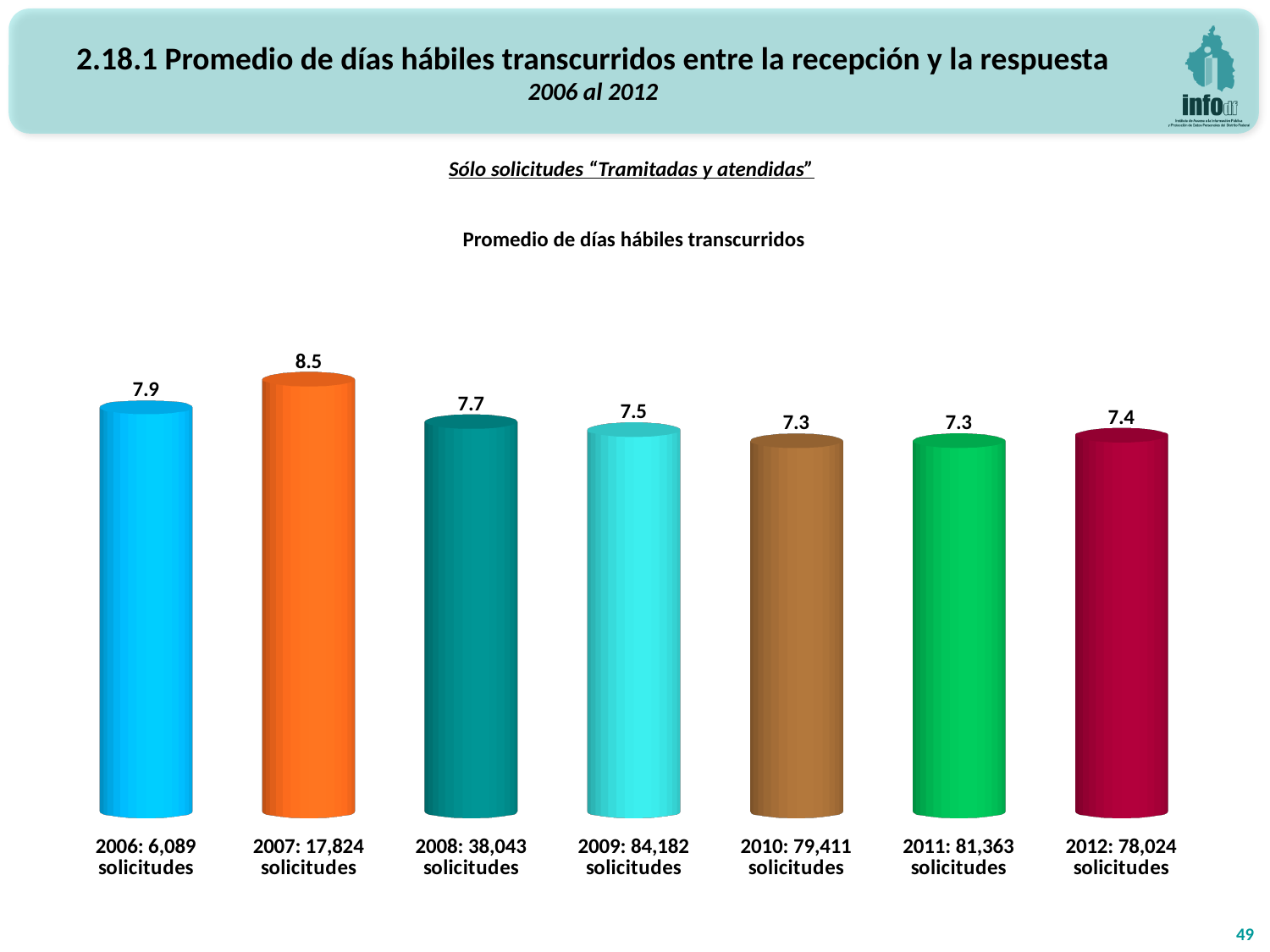
What is the value shown for 2012: 78,024 solicitudes? 7.4 What is the value shown for 2009? 7.5 Which is larger, the value for 2006 or the value for 2012? 2006 What is the difference between the values for 2008 and 2010? 0.4 What kind of chart is shown on the slide? Bar chart What is the lowest value shown in the chart? 7.3 Do the values generally rise or fall from 2007 to 2010? Fall What is the title of the chart? Promedio de días hábiles transcurridos What is the difference between the values for 2007 and 2006? 0.6 Which year has the highest average number of business days elapsed? 2007 How many bars are shown in the chart? 7 What is the average number of business days elapsed for 2007? 8.5